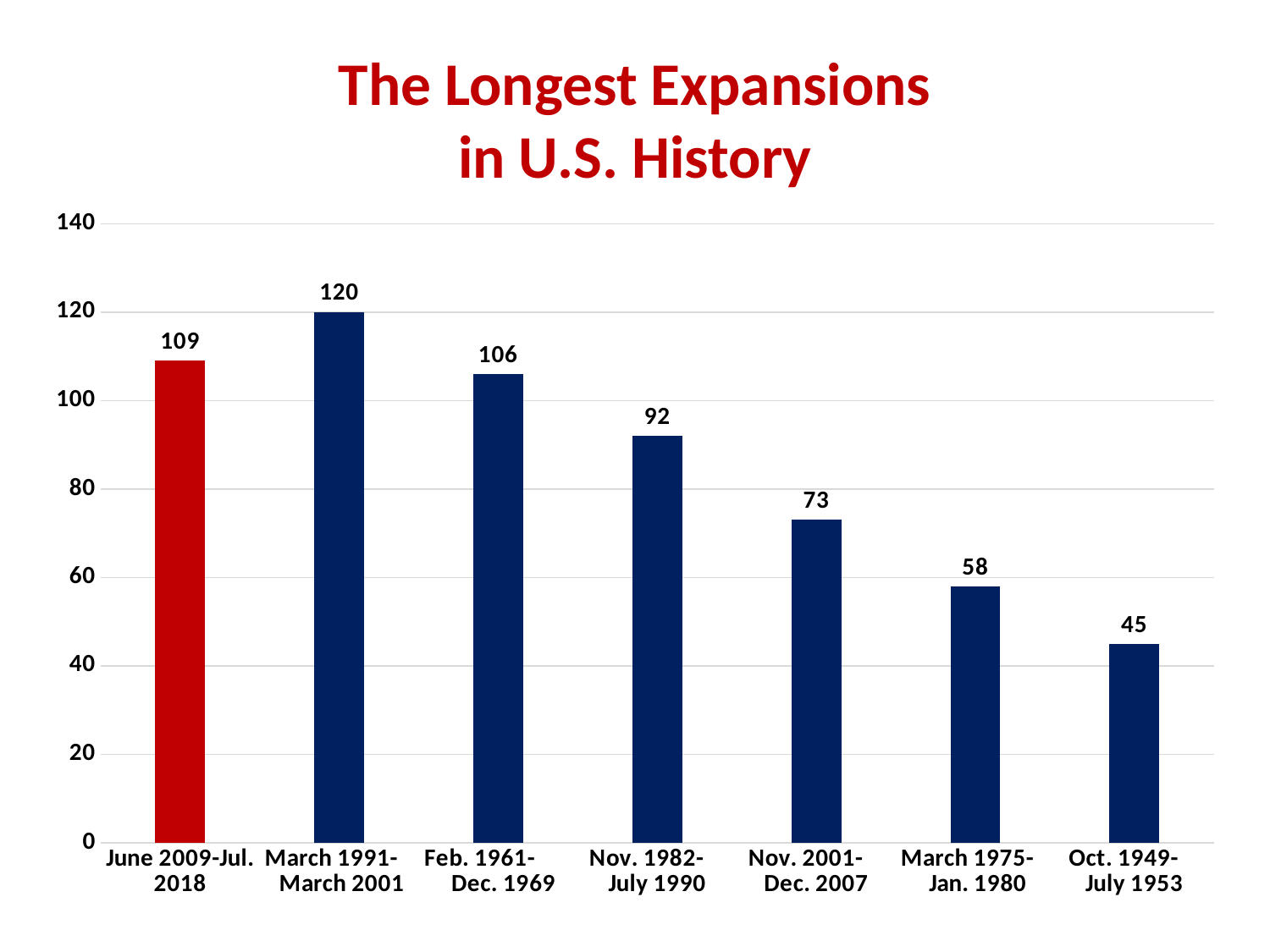
What kind of chart is shown on the slide? bar chart How many expansions are shown in the chart? 7 What is the value for the June 2009-Jul. 2018 expansion? 109 What is the value for the March 1991-March 2001 expansion? 120 Is the value for Nov. 1982-July 1990 greater or less than 100? less What is the difference between the values for Feb. 1961-Dec. 1969 and Nov. 1982-July 1990? 14 Which bar is coloured red rather than dark blue? June 2009-Jul. 2018 Which expansion has the lowest value? Oct. 1949-July 1953 Which is larger, the value for March 1975-Jan. 1980 or the value for Oct. 1949-July 1953? March 1975-Jan. 1980 Which expansion has the highest value? March 1991-March 2001 What is the value for the Nov. 2001-Dec. 2007 expansion? 73 What is the difference between the values for March 1991-March 2001 and June 2009-Jul. 2018? 11